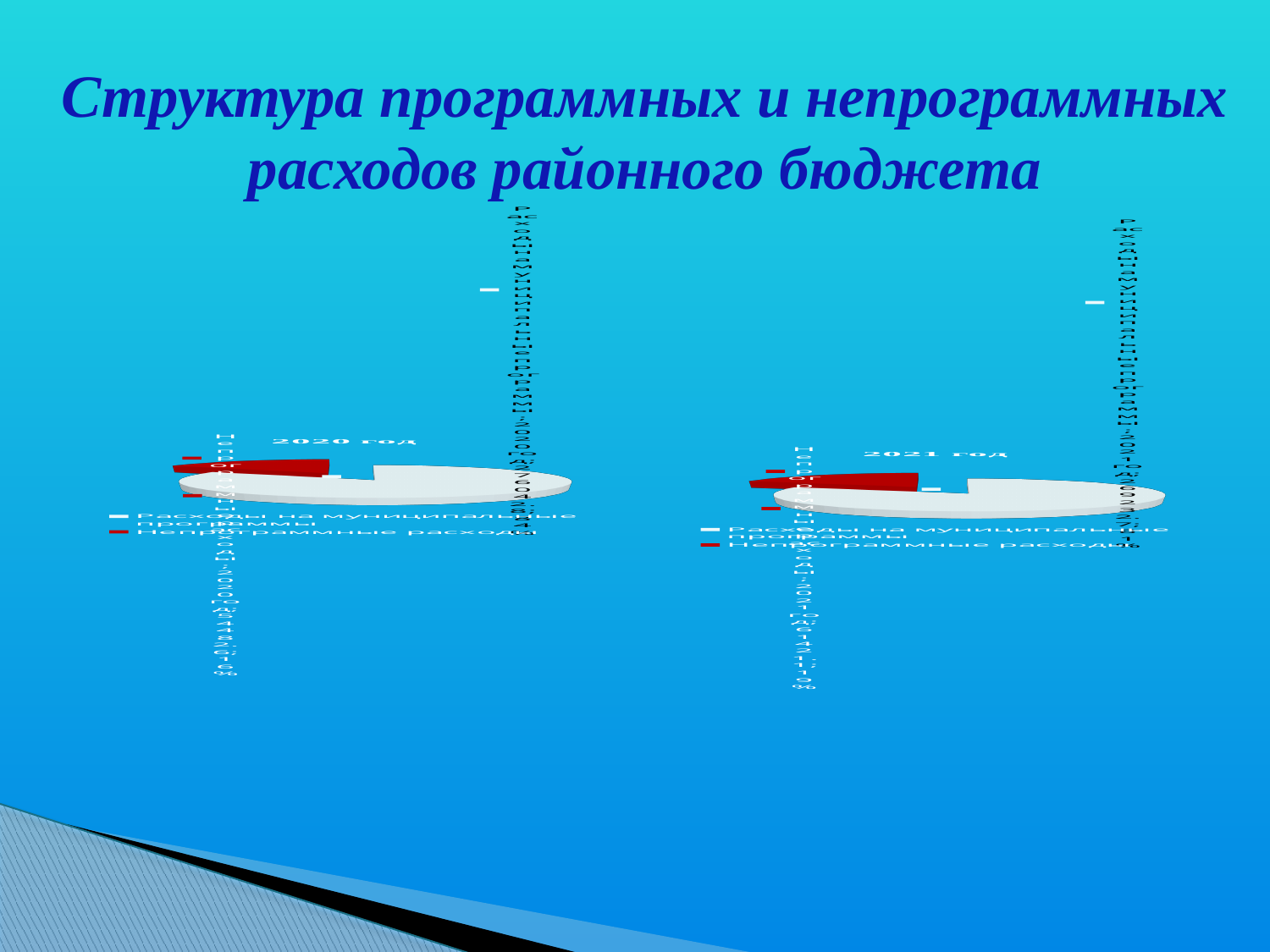
How many slices does the "2021 год" pie chart have? 2 How many entries does the legend of the "2020 год" chart list? 2 What is the title of the chart on the right side of the slide? 2021 год In the "2021 год" chart, which category has the largest slice? Расходы на муниципальные программы In the "2020 год" chart, which category has the smallest slice? Непрограммные расходы In the "2021 год" chart, which slice is larger: "Расходы на муниципальные программы" or "Непрограммные расходы"? Расходы на муниципальные программы What colour represents "Непрограммные расходы" in the "2020 год" chart? red What kind of chart is the chart titled "2020 год"? pie chart What kind of chart is the chart titled "2021 год"? pie chart How many entries does the legend of the "2021 год" chart list? 2 In the "2020 год" chart, which slice is larger: "Расходы на муниципальные программы" or "Непрограммные расходы"? Расходы на муниципальные программы